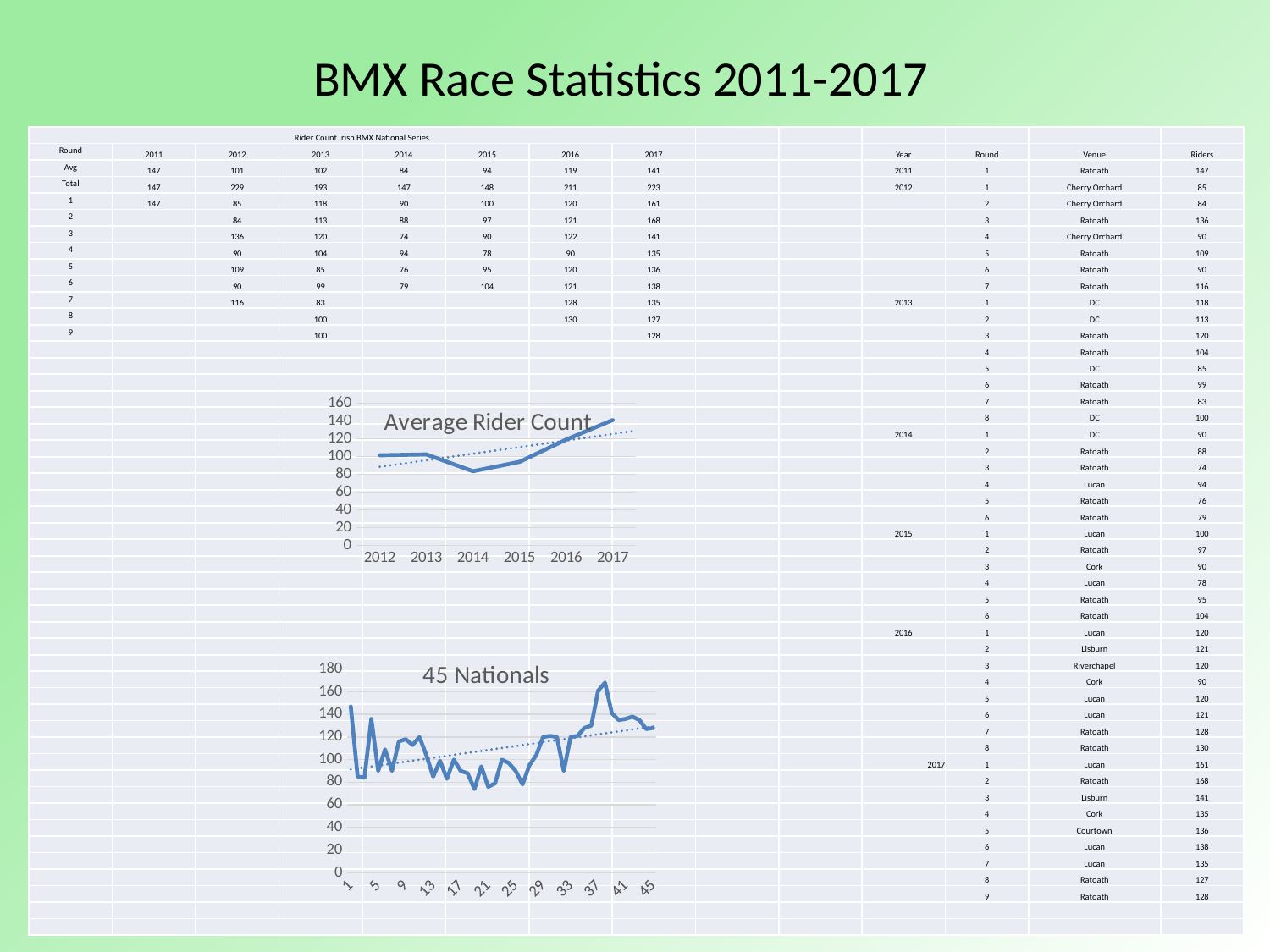
In the "Average Rider Count" chart, is the value for 2016 greater or less than 100? greater In the "45 Nationals" chart, is the value for point 1 greater or less than 120? greater In the "Average Rider Count" chart, which is larger, the value for 2016 or the value for 2015? 2016 What kind of chart is the "45 Nationals" chart? line chart In the "Average Rider Count" chart, which year has the highest average rider count? 2017 In the "Average Rider Count" chart, does the value rise or fall from 2014 to 2017? rise How many years are plotted on the x axis of the "Average Rider Count" chart? 6 In the "Average Rider Count" chart, is the value for 2014 greater or less than 100? less What kind of chart is the "Average Rider Count" chart? line chart What is the highest value shown on the y axis of the "45 Nationals" chart? 180 In the "Average Rider Count" chart, which year has the lowest average rider count? 2014